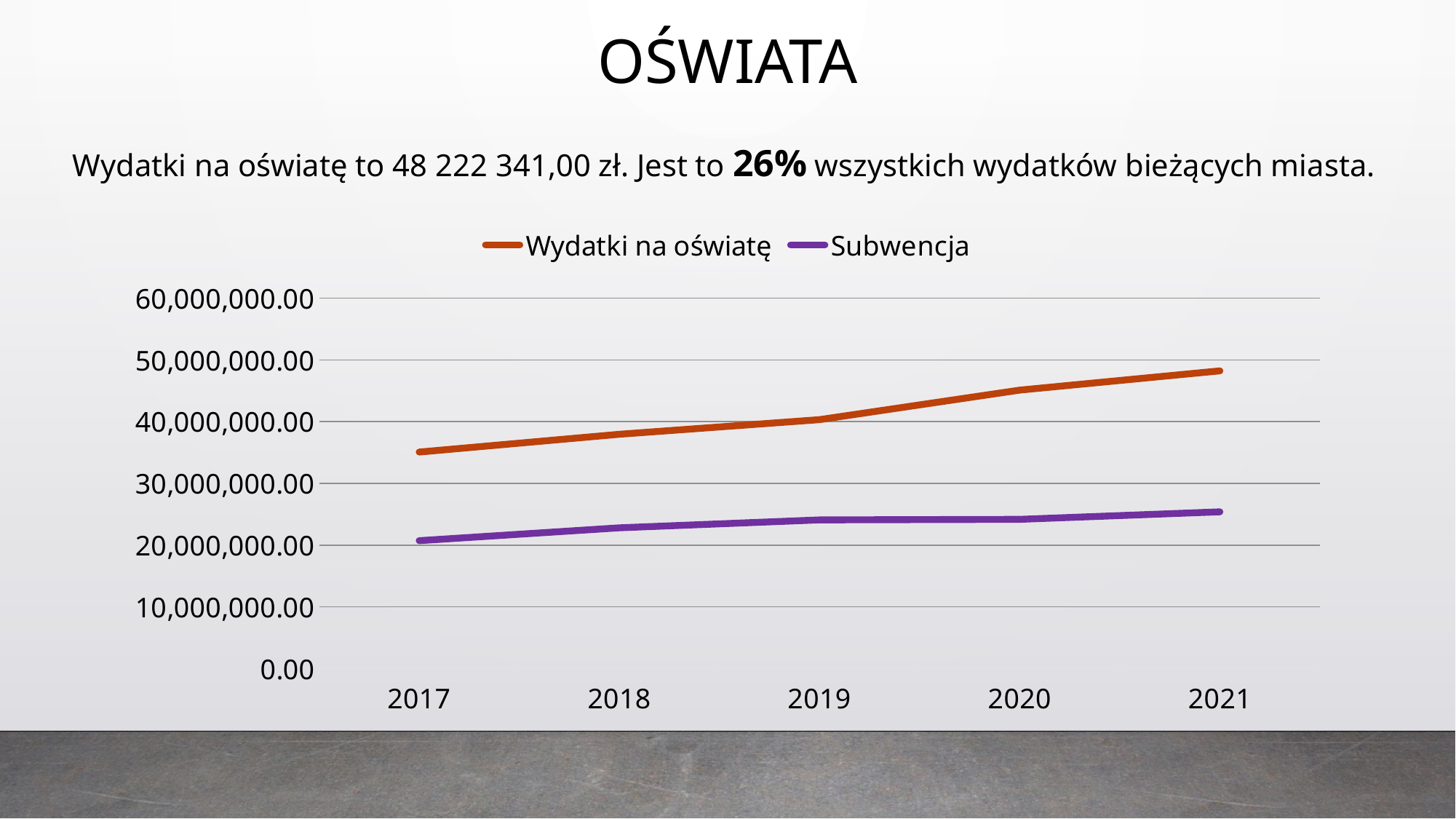
Is the value for Wydatki na oświatę in 2021 greater or less than 50,000,000.00? less In which year is Subwencja lowest? 2017 What kind of chart is shown on the slide? Line chart In which year is Wydatki na oświatę highest? 2021 Is the value for Wydatki na oświatę in 2017 greater or less than 30,000,000.00? greater Does the Wydatki na oświatę line rise or fall from 2017 to 2021? Rises How many series does the chart legend list? 2 What colour is the Subwencja line in the chart? Purple Is the value for Wydatki na oświatę in 2020 greater or less than 40,000,000.00? greater Which series has the larger value in 2019, Wydatki na oświatę or Subwencja? Wydatki na oświatę How many years are plotted along the x axis of the chart? 5